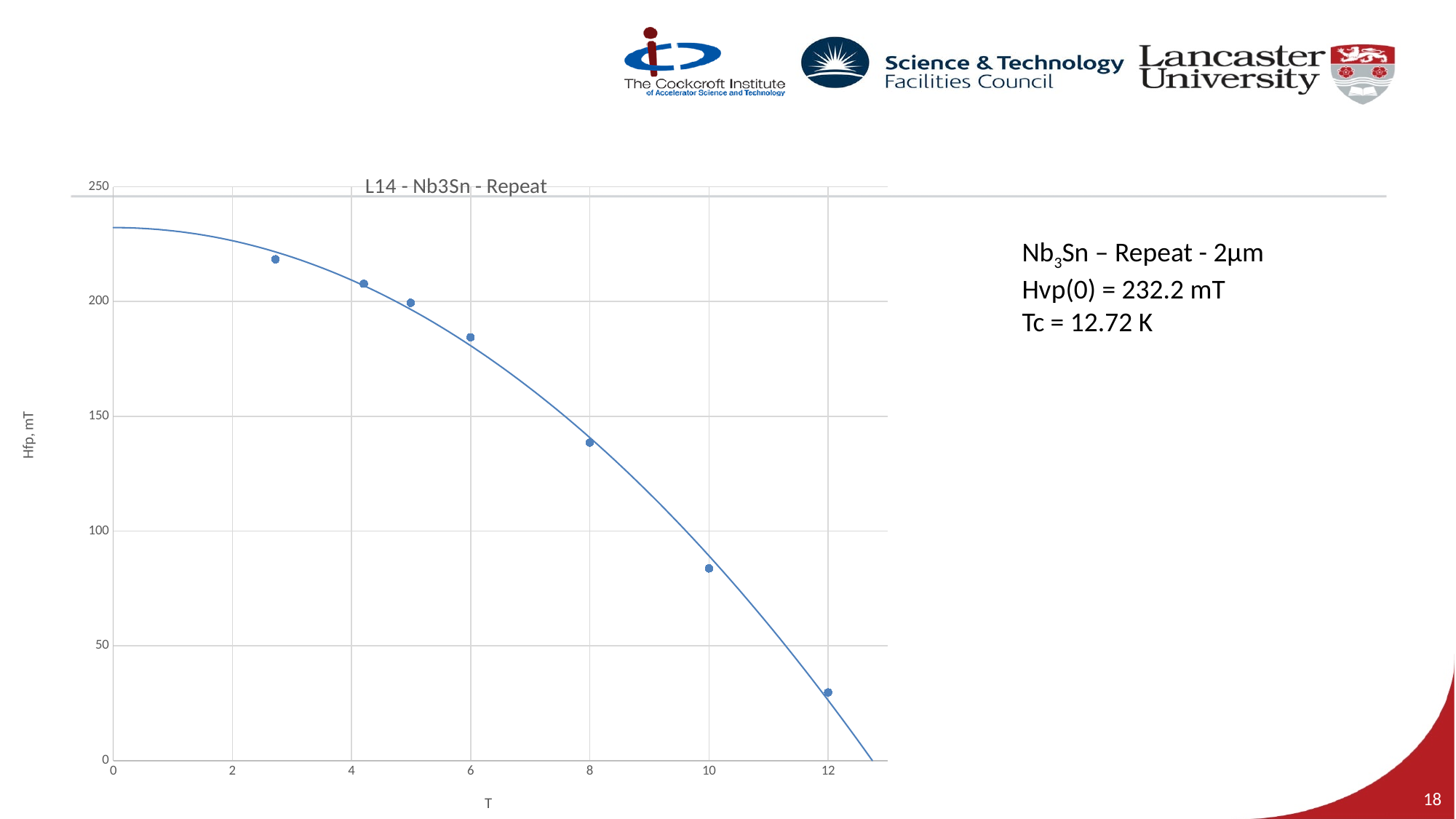
What is the title of the chart? L14 - Nb3Sn - Repeat Is the value for the data point at T = 10 greater or less than 100? less Is the value for the data point at T = 6 greater or less than 150? greater Do the plotted values rise or fall as T increases along the x axis? fall Is the value for the data point at T = 8 greater or less than 150? less Which data point has the lowest Hfp value, the one at T = 12 or the one at T = 10? T = 12 What kind of chart is shown on the slide? scatter chart How many data points are plotted on the chart? 7 What is the label of the y axis? Hfp, mT